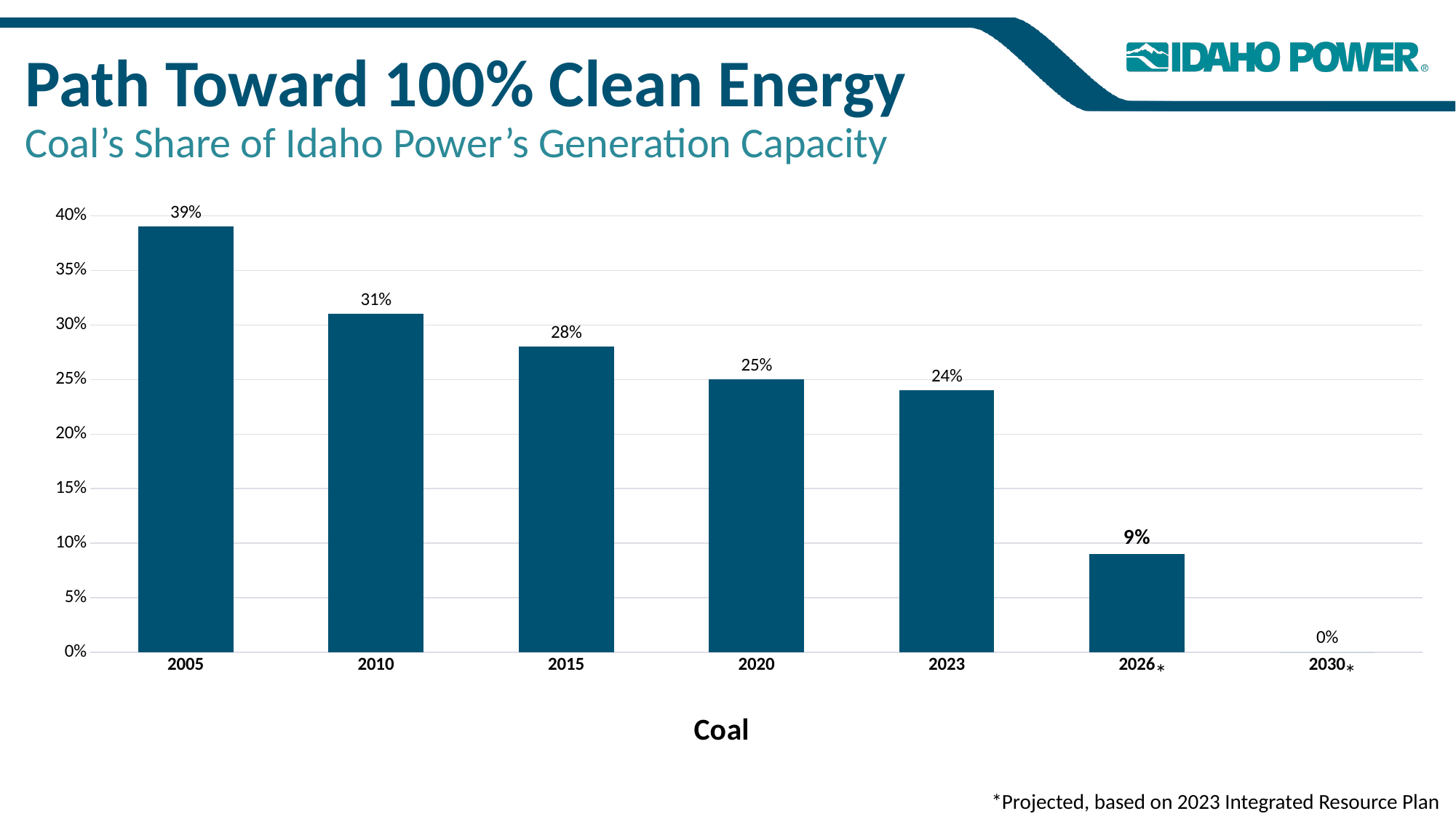
What is the projected coal share for 2030? 0% Which year has the lowest coal share? 2030 What is the difference between the coal share in 2005 and in 2023? 15% What is the difference between the coal share in 2010 and in 2015? 3% Which is larger, the coal share in 2020 or in 2023? 2020 Which year has the highest coal share? 2005 What is the projected coal share for 2026? 9% What is coal's share of generation capacity in 2005? 39% What is coal's share of generation capacity in 2023? 24% Do the values rise or fall from 2005 to 2030? Fall What kind of chart is shown on the slide? Bar chart How many years are shown on the x axis? 7